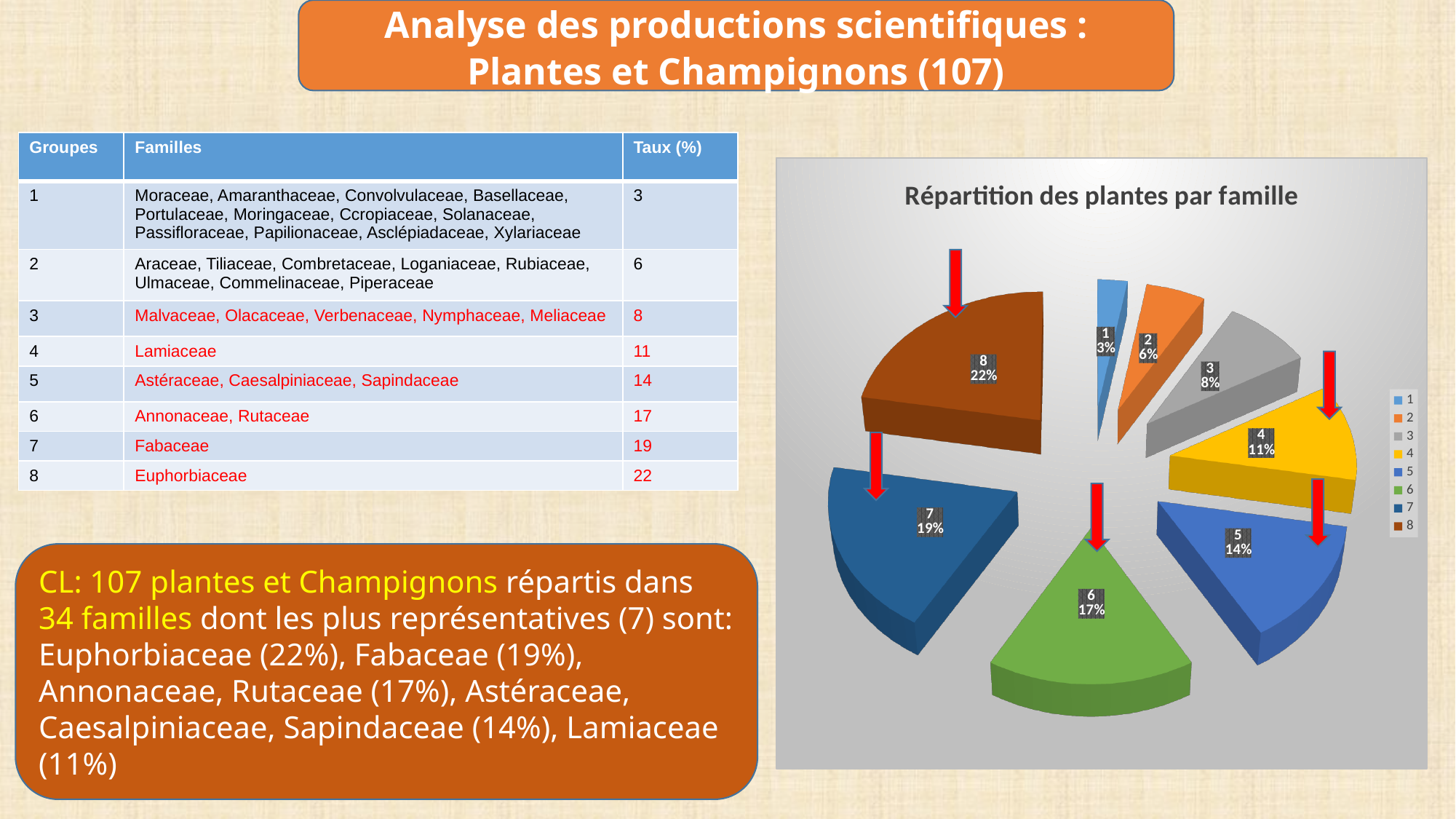
What percentage is shown for group 8 in the pie chart? 22% Which is larger in the pie chart, group 5 or group 3? group 5 What type of chart is shown on the slide? pie chart How many slices does the pie chart have? 8 What percentage is shown for group 4 in the pie chart? 11% How many entries does the legend list? 8 What is the combined share of groups 7 and 8 in the pie chart? 41% What is the title of the chart? Répartition des plantes par famille Which group has the largest slice in the pie chart? 8 What is the difference in percentage points between group 7 and group 6? 2 Which group has the smallest slice in the pie chart? 1 What percentage is shown for group 1 in the pie chart? 3%